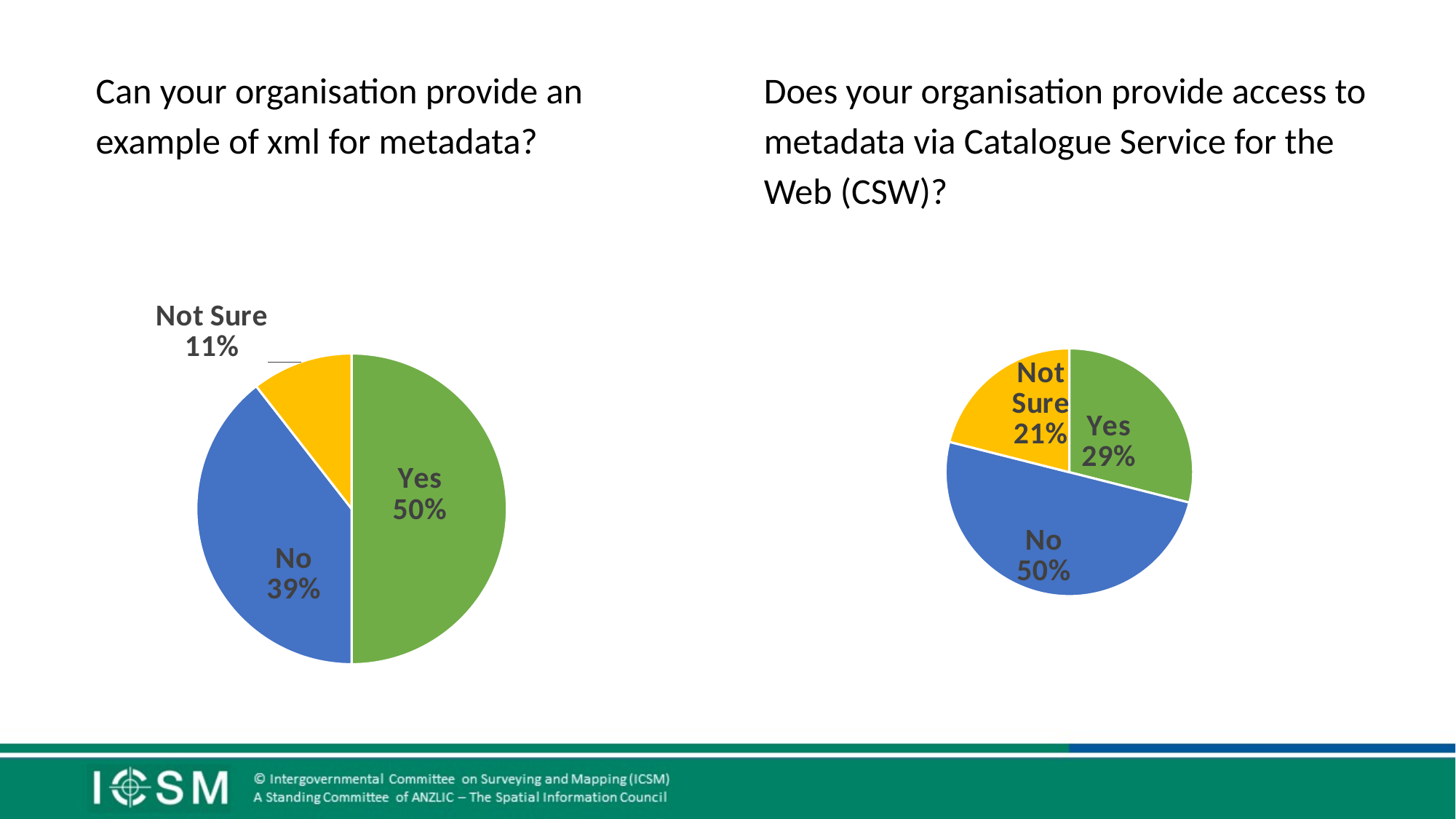
In the left pie chart (Can your organisation provide an example of xml for metadata?), what share of responses is 'No'? 39% In the right pie chart (Does your organisation provide access to metadata via CSW?), what share of responses is 'Yes'? 29% In the left pie chart (Can your organisation provide an example of xml for metadata?), which response has the smallest share? Not Sure In the left pie chart (Can your organisation provide an example of xml for metadata?), what share of responses is 'Yes'? 50% How many slices does the left pie chart (Can your organisation provide an example of xml for metadata?) have? 3 In the right pie chart (Does your organisation provide access to metadata via CSW?), what is the difference in percentage points between 'No' and 'Yes'? 21 In the right pie chart (Does your organisation provide access to metadata via CSW?), which response has the largest share? No In the left pie chart (Can your organisation provide an example of xml for metadata?), what share of responses is 'Not Sure'? 11% What type of chart is used on the right side of the slide (Does your organisation provide access to metadata via CSW?)? Pie chart In the right pie chart (Does your organisation provide access to metadata via CSW?), which is larger, 'Yes' or 'Not Sure'? Yes In the left pie chart (Can your organisation provide an example of xml for metadata?), what is the difference in percentage points between 'Yes' and 'No'? 11 In the right pie chart (Does your organisation provide access to metadata via CSW?), what share of responses is 'Not Sure'? 21%